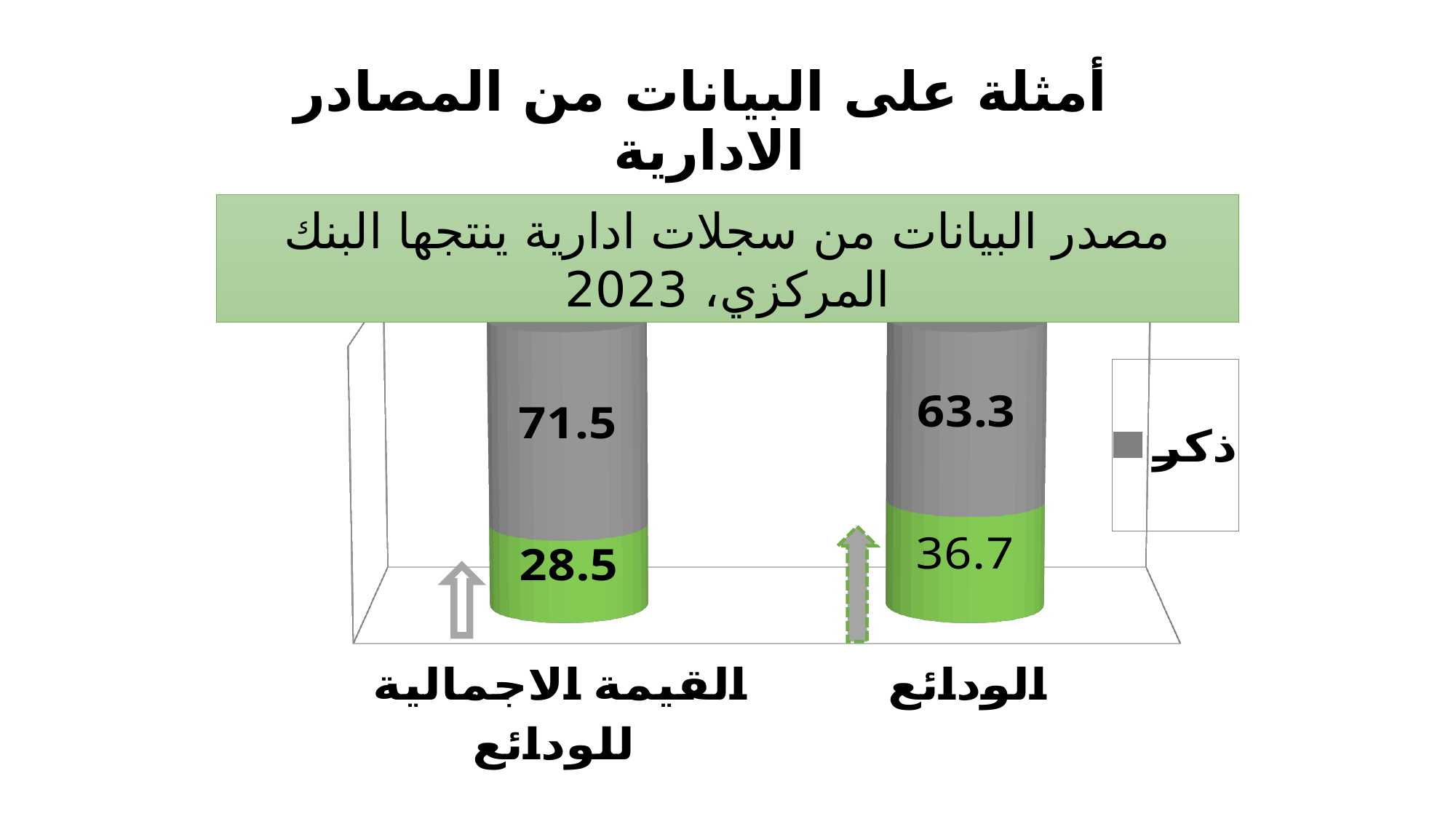
What is the total of the stacked bar for الودائع? 100 What is the value of the green segment for الودائع? 36.7 Which colour represents ذكر in the legend? grey For الودائع, what is the difference between the ذكر value and the green segment value? 26.6 What is the total of the stacked bar for القيمة الاجمالية للودائع? 100 What is the value of the green segment for القيمة الاجمالية للودائع? 28.5 What is the difference between the ذكر values for القيمة الاجمالية للودائع and الودائع? 8.2 What is the value of ذكر for الودائع? 63.3 How many categories are shown on the x axis of the chart? 2 What kind of chart is shown on the slide? bar chart Which category has the larger ذكر value, الودائع or القيمة الاجمالية للودائع? القيمة الاجمالية للودائع What is the value of ذكر for القيمة الاجمالية للودائع? 71.5